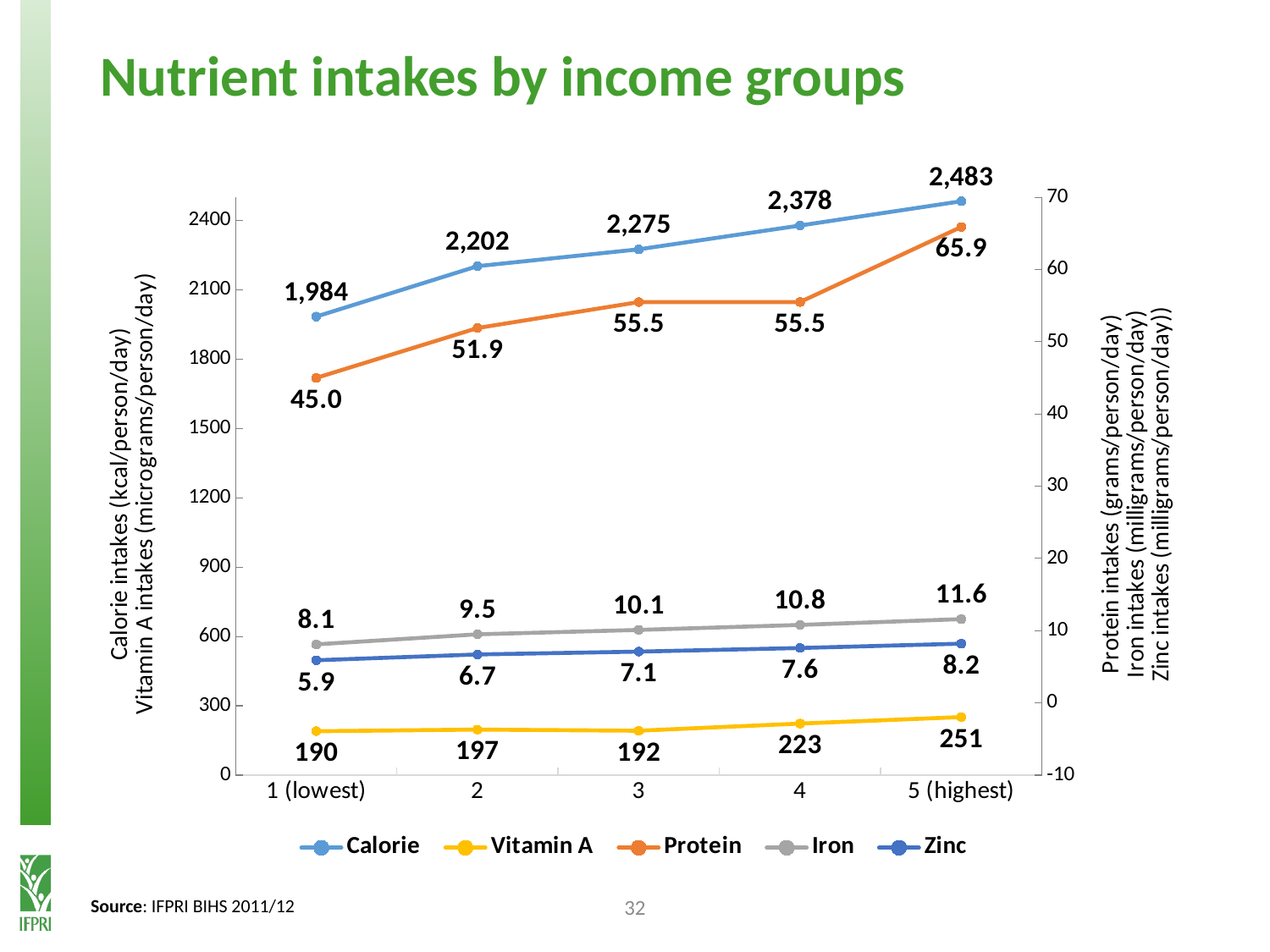
What is the Protein intake for income group 5 (highest)? 65.9 What is the Calorie intake for income group 1 (lowest)? 1,984 What is the Zinc intake for income group 3? 7.1 What is the difference in Calorie intake between income group 5 (highest) and income group 1 (lowest)? 499 Is the Protein intake for income group 2 larger or smaller than for income group 4? smaller How many income groups are shown on the x axis? 5 What is the Vitamin A intake for income group 4? 223 Which income group has the highest Iron intake? 5 (highest) Which income group has the lowest Vitamin A intake? 1 (lowest) What kind of chart is shown on the slide? line chart Does the Calorie intake rise or fall from income group 1 (lowest) to income group 5 (highest)? rise How many series does the legend list? 5